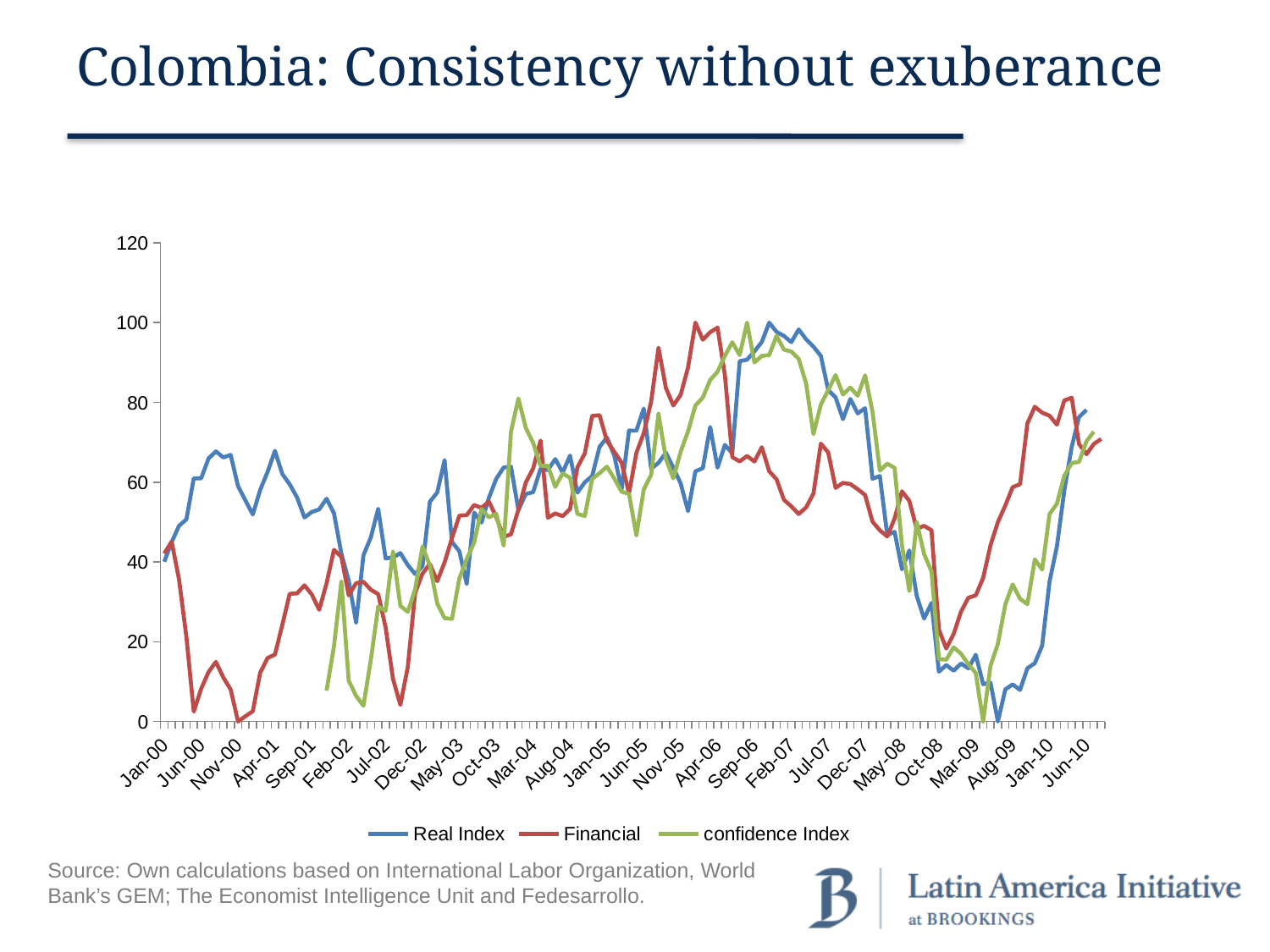
Does the Financial series rise or fall between Mar-09 and Jan-10? rise Does the Real Index rise or fall between Feb-07 and Oct-08? fall What are the three series named in the legend? Real Index, Financial, confidence Index What is the title of the slide containing the chart? Colombia: Consistency without exuberance Is the value of the Financial series at Nov-00 greater or less than 20? less What kind of chart is shown on the slide? line chart At Nov-00, which is larger: the Real Index or the Financial series? Real Index Is the value of the Real Index at Oct-08 greater or less than 20? less Is the value of the Financial series at Apr-06 greater or less than 80? greater How many series does the legend list? 3